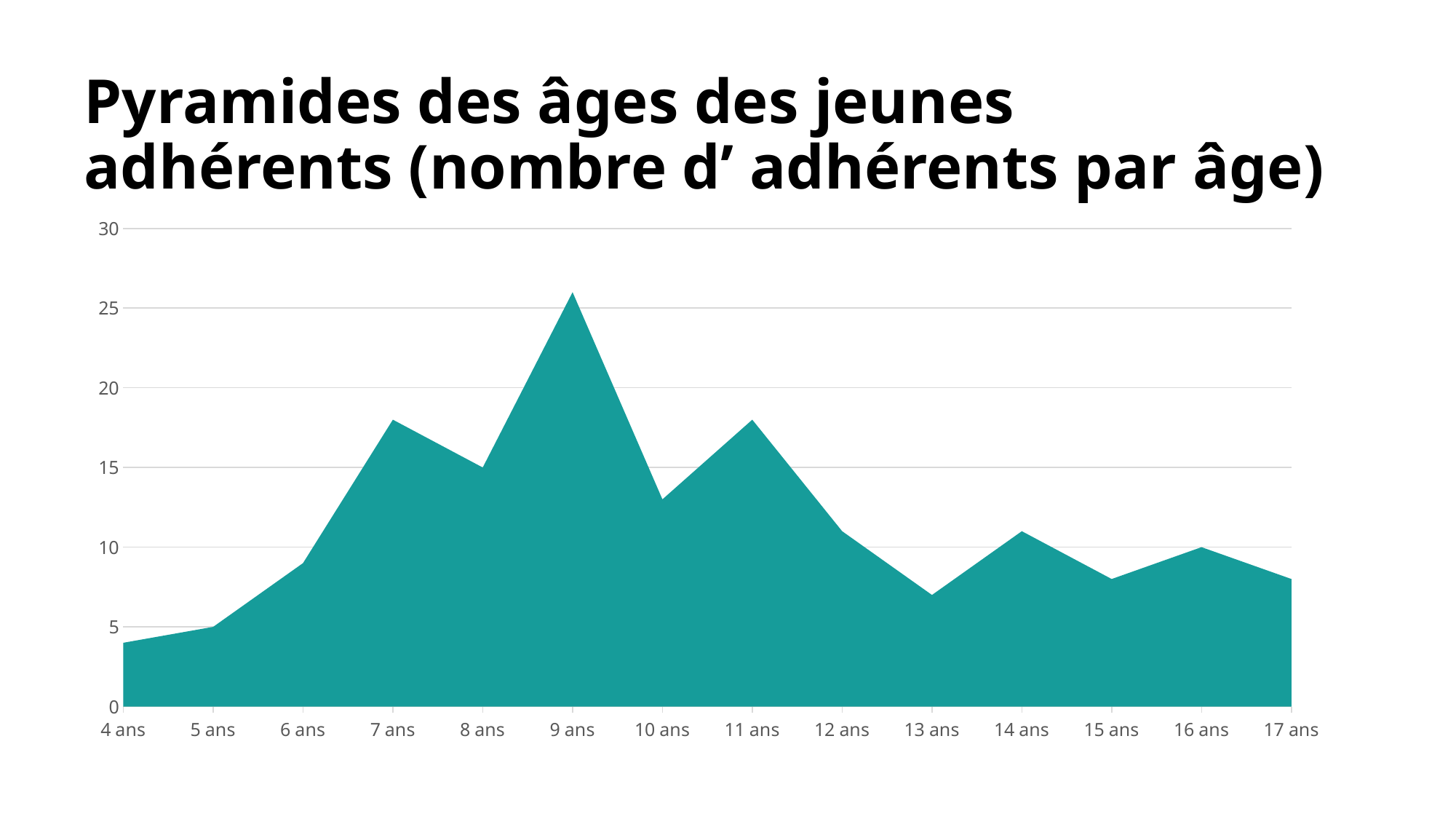
What is the number of adherents for 5 ans? 5 What kind of chart is shown on the slide? area chart Which age has the lowest number of adherents? 4 ans Is the value for 9 ans greater or less than 25? greater How many age categories are shown on the x axis? 14 Which age has the highest number of adherents? 9 ans What is the number of adherents for 16 ans? 10 What is the number of adherents for 8 ans? 15 Do the values rise or fall from 4 ans to 9 ans? rise Which has more adherents, 13 ans or 14 ans? 14 ans Is the value for 7 ans greater or less than 15? greater Is the value for 13 ans greater or less than 10? less